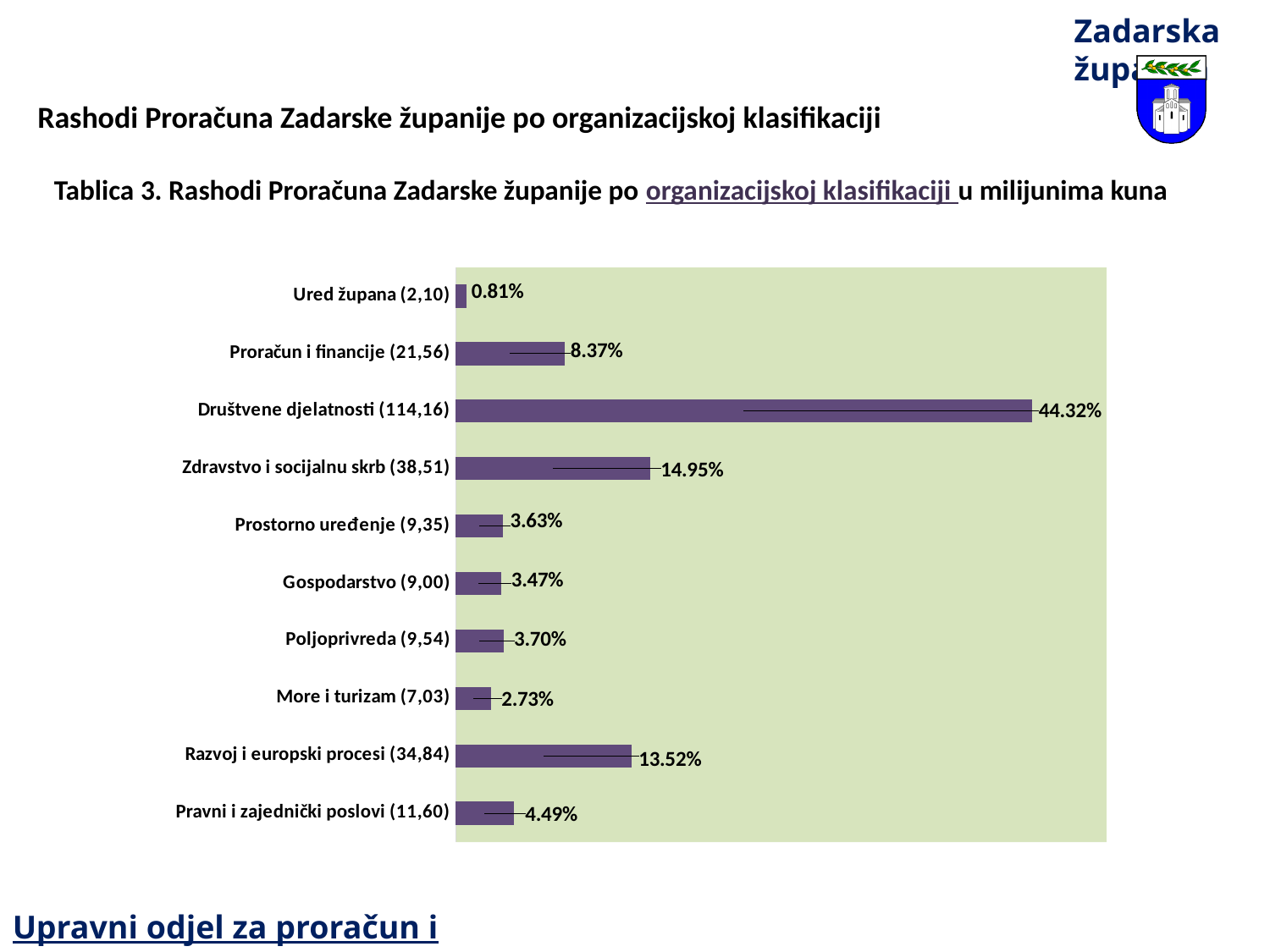
What percentage is shown for More i turizam (7,03)? 2.73% Which category has the highest percentage? Društvene djelatnosti (114,16) What is the difference in percentage points between Društvene djelatnosti (114,16) and Zdravstvo i socijalnu skrb (38,51)? 29.37 What kind of chart is shown on the slide? Bar chart What percentage is shown for Razvoj i europski procesi (34,84)? 13.52% Which category has the lowest percentage? Ured župana (2,10) Which is larger, the percentage for Proračun i financije (21,56) or for Pravni i zajednički poslovi (11,60)? Proračun i financije (21,56) What percentage is shown for Pravni i zajednički poslovi (11,60)? 4.49% What is the title of the chart on the slide? Tablica 3. Rashodi Proračuna Zadarske županije po organizacijskoj klasifikaciji u milijunima kuna What percentage is shown for Zdravstvo i socijalnu skrb (38,51)? 14.95% How many categories are shown in the chart? 10 What percentage is shown for Društvene djelatnosti (114,16)? 44.32%